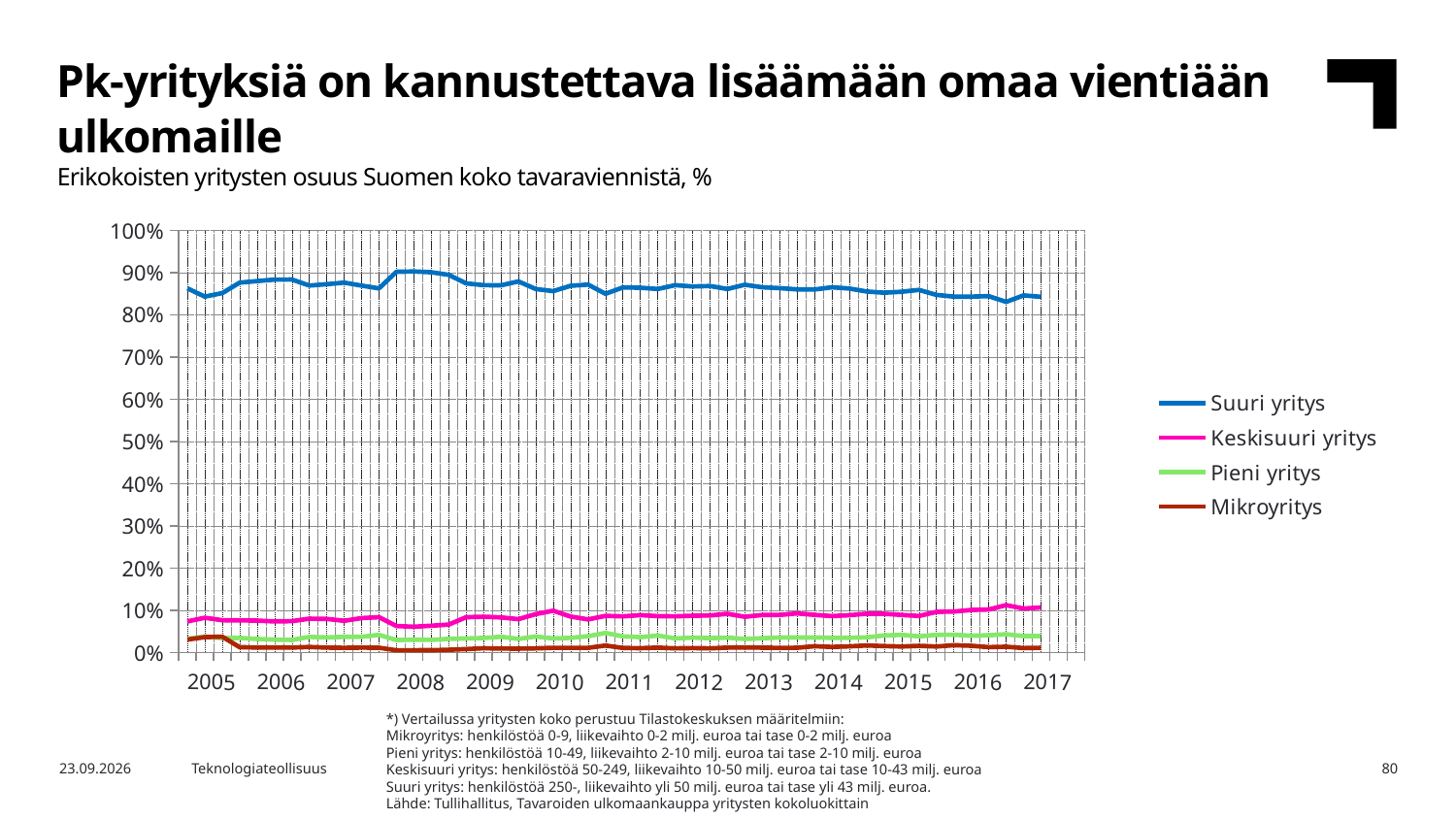
Is the value for Pieni yritys in 2010 greater or less than 10%? less Which colour is used for the Mikroyritys series? dark red What kind of chart is shown on the slide? line chart How many years are labelled on the x axis? 13 How many series does the legend list? 4 Which series has larger values, Keskisuuri yritys or Pieni yritys? Keskisuuri yritys Which series has the highest values throughout the chart? Suuri yritys Is the value for Keskisuuri yritys in 2017 greater or less than 20%? less Which series has the lowest values throughout the chart? Mikroyritys What is the subtitle describing the chart's content? Erikokoisten yritysten osuus Suomen koko tavaraviennistä, % Is the value for Suuri yritys in 2017 greater or less than 80%? greater